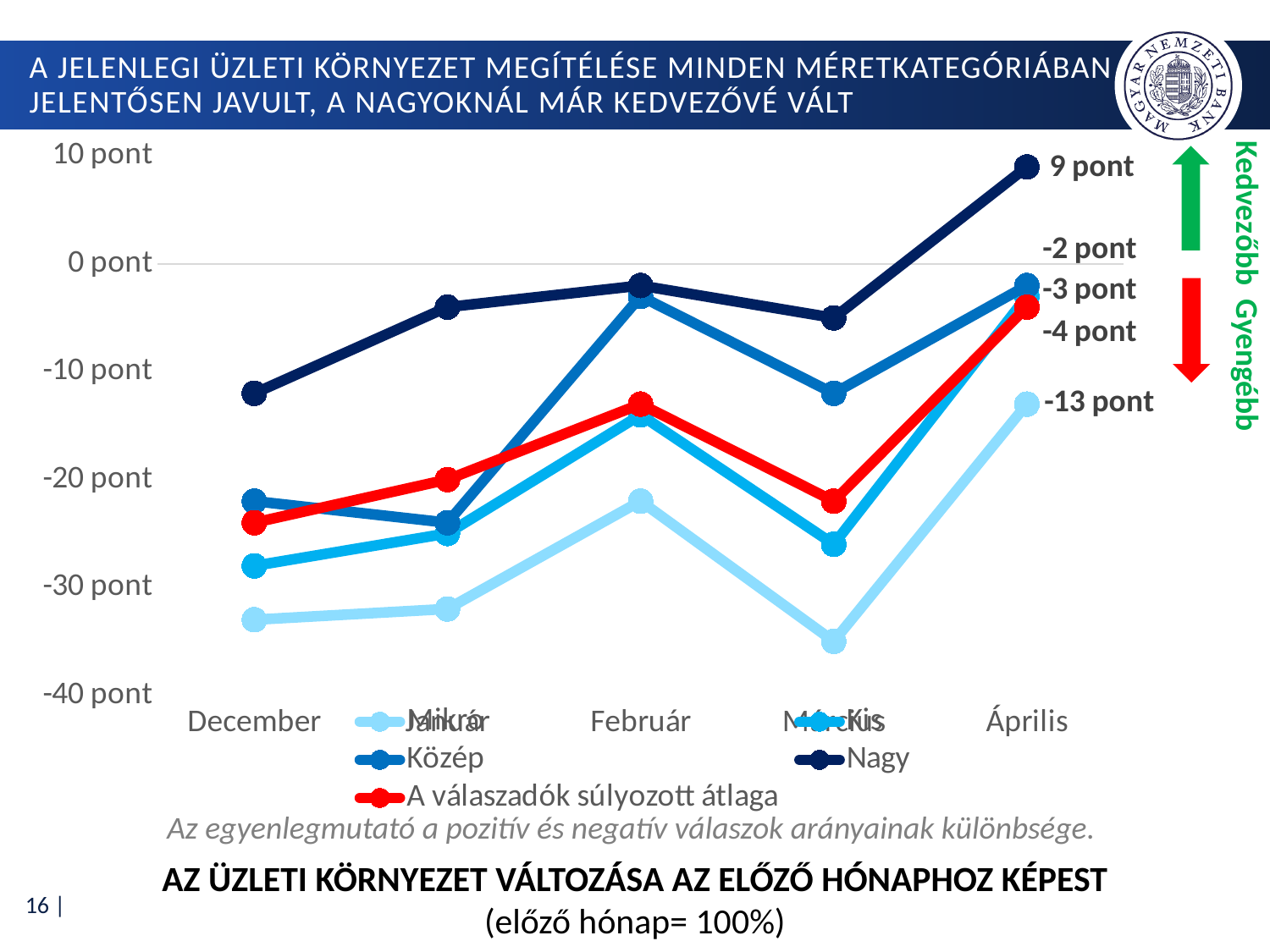
What kind of chart is shown on the slide? line chart What is the value for Mikro in Április? -13 pont How many months are shown on the x axis? 5 Is the value for Nagy in Február greater or less than -10 pont? greater What is the value for Nagy in Április? 9 pont Which series has the lowest value in Április? Mikro What is the difference between the Nagy and Mikro values in Április? 22 pont Which is larger in Február, the value for Nagy or the value for Mikro? Nagy How many series does the legend list? 5 Is the value for Mikro in December greater or less than -30 pont? less Which series has the highest value in Április? Nagy What is the value for A válaszadók súlyozott átlaga in Április? -4 pont